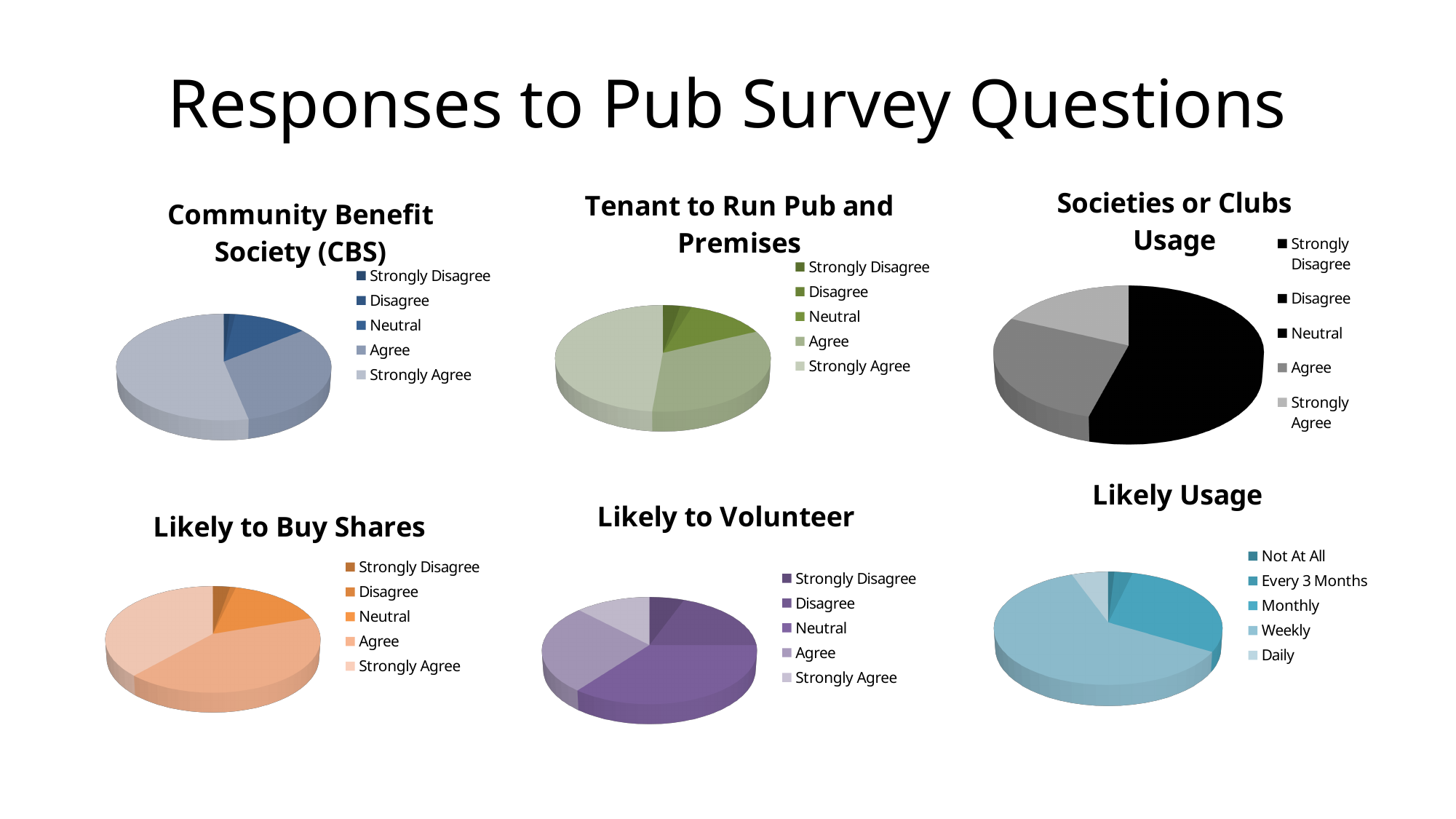
In the "Likely Usage" chart, which category has the smallest slice? Not At All In the "Likely to Buy Shares" chart, which category has the largest slice? Agree How many charts are shown on the slide? 6 In the "Tenant to Run Pub and Premises" chart, which category has the largest slice? Strongly Agree What is the title of the slide? Responses to Pub Survey Questions What kind of chart is the "Likely Usage" chart? Pie chart How many categories does the legend of the "Community Benefit Society (CBS)" chart list? 5 In the "Societies or Clubs Usage" chart, which slice is larger, Agree or Strongly Agree? Agree How many entries does the legend of the "Likely Usage" chart list? 5 In the "Community Benefit Society (CBS)" chart, which category has the largest slice? Strongly Agree In the "Likely to Volunteer" chart, which slice is larger, Agree or Strongly Agree? Agree